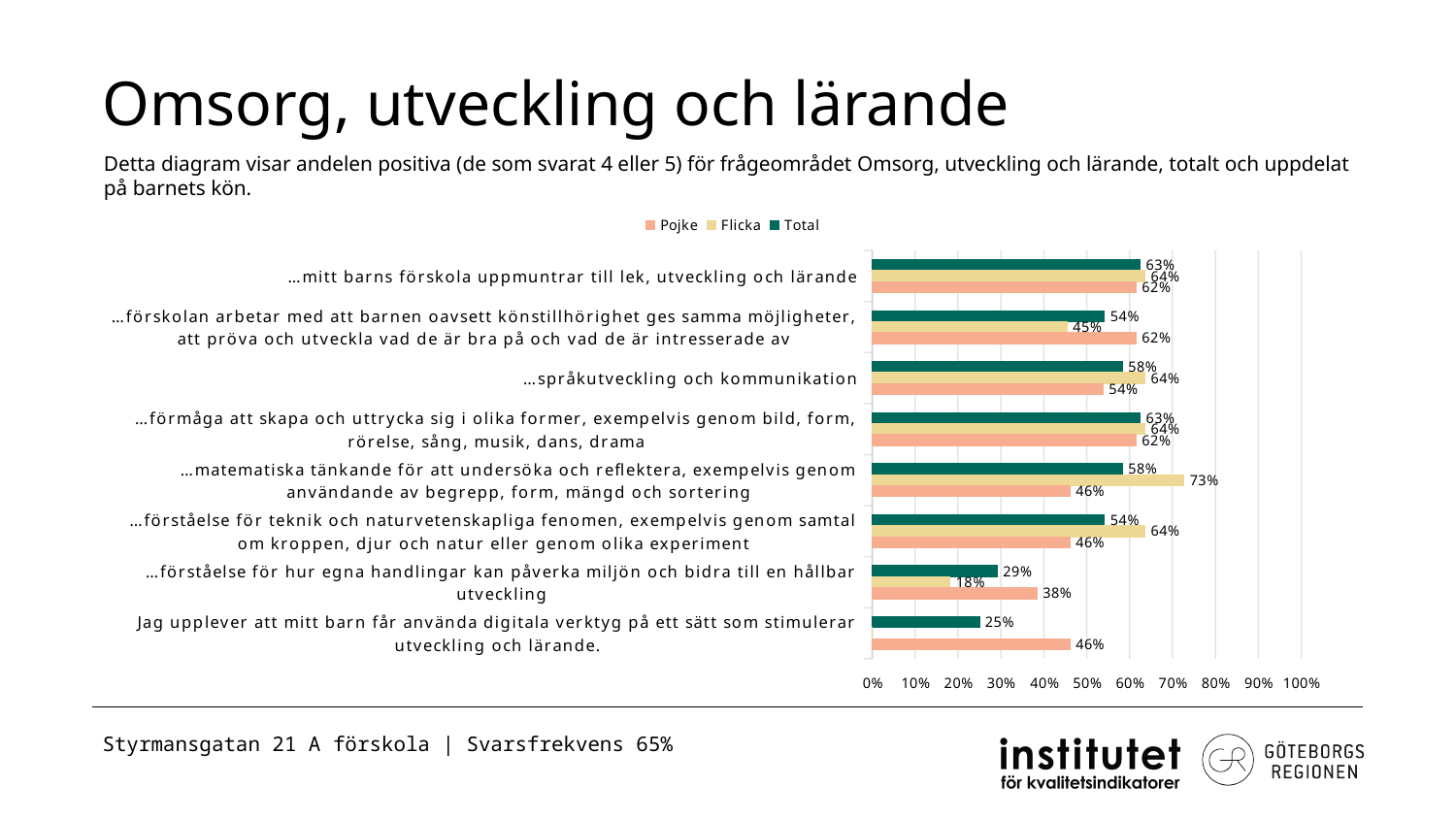
What kind of chart is shown on the slide? Bar chart What is the Total value for "…förståelse för hur egna handlingar kan påverka miljön och bidra till en hållbar utveckling"? 29% What is the Flicka value for "…matematiska tänkande för att undersöka och reflektera, exempelvis genom användande av begrepp, form, mängd och sortering"? 73% What is the Pojke value for "Jag upplever att mitt barn får använda digitala verktyg på ett sätt som stimulerar utveckling och lärande."? 46% How many series does the legend list? 3 Which category has the lowest Total value? Jag upplever att mitt barn får använda digitala verktyg på ett sätt som stimulerar utveckling och lärande. What are the three series named in the legend? Pojke, Flicka, Total How many question categories are shown on the chart? 8 For "…matematiska tänkande…", what is the difference between the Flicka value and the Pojke value? 27 percentage points For "…språkutveckling och kommunikation", which is larger: the Flicka value or the Pojke value? Flicka For "…förskolan arbetar med att barnen oavsett könstillhörighet ges samma möjligheter…", how many percentage points higher is the Pojke value than the Flicka value? 17 percentage points Which category has the highest Flicka value? …matematiska tänkande för att undersöka och reflektera, exempelvis genom användande av begrepp, form, mängd och sortering